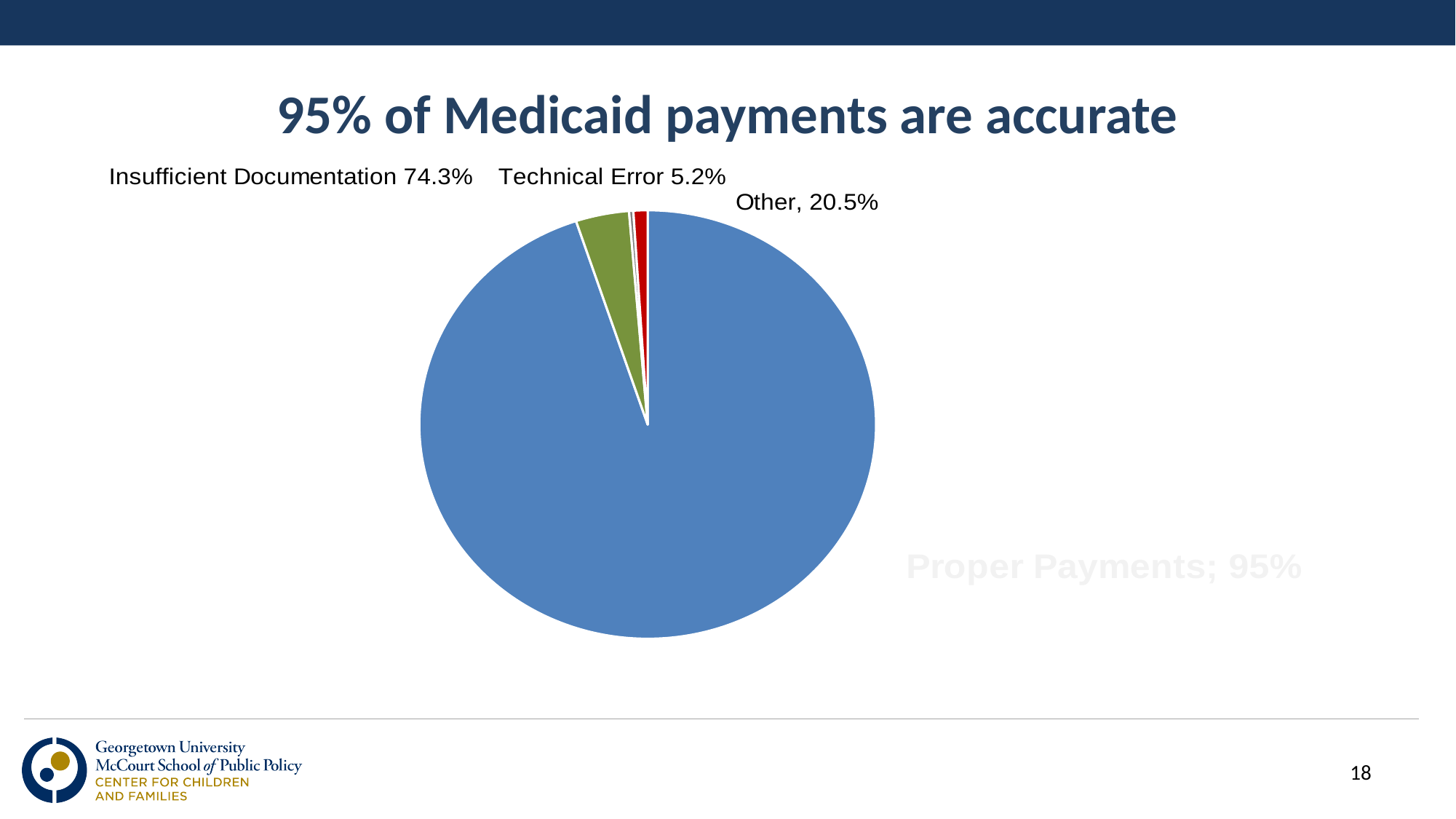
What type of chart is shown on the slide? pie chart What is the title of the slide's chart? 95% of Medicaid payments are accurate Which has the larger printed percentage, Insufficient Documentation or Other? Insufficient Documentation What percentage is printed for Proper Payments? 95% How many labeled categories does the pie chart have? 4 What percentage is printed for Technical Error? 5.2% What colour is the Proper Payments slice? blue Which of the three error categories has the smallest printed percentage? Technical Error What is the difference between the printed percentages for Insufficient Documentation and Other? 53.8% What percentage is printed for Insufficient Documentation? 74.3% What percentage is printed for Other? 20.5% Which category takes up the largest slice of the pie? Proper Payments